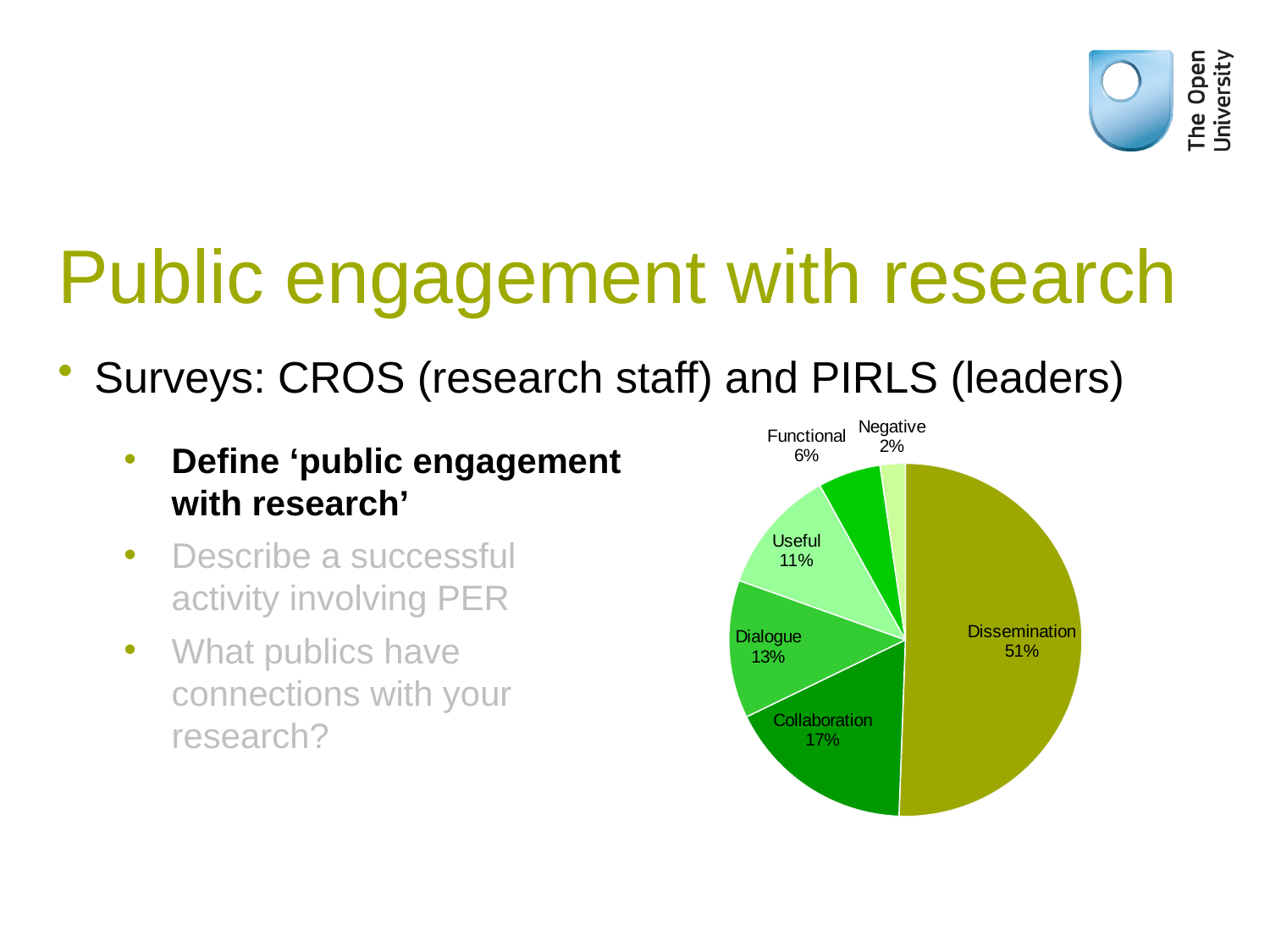
What kind of chart is shown on the slide? pie chart Which category has the largest slice of the pie? Dissemination What share of the pie does Functional have? 6% What share of the pie does Dialogue have? 13% How many categories are shown in the pie chart? 6 What is the difference in percentage points between Dissemination and Collaboration? 34 Which category has the smallest slice of the pie? Negative What share of the pie does Dissemination have? 51% Which is larger, the Dialogue slice or the Useful slice? Dialogue What share of the pie does Collaboration have? 17% What share of the pie does Useful have? 11% What share of the pie does Negative have? 2%